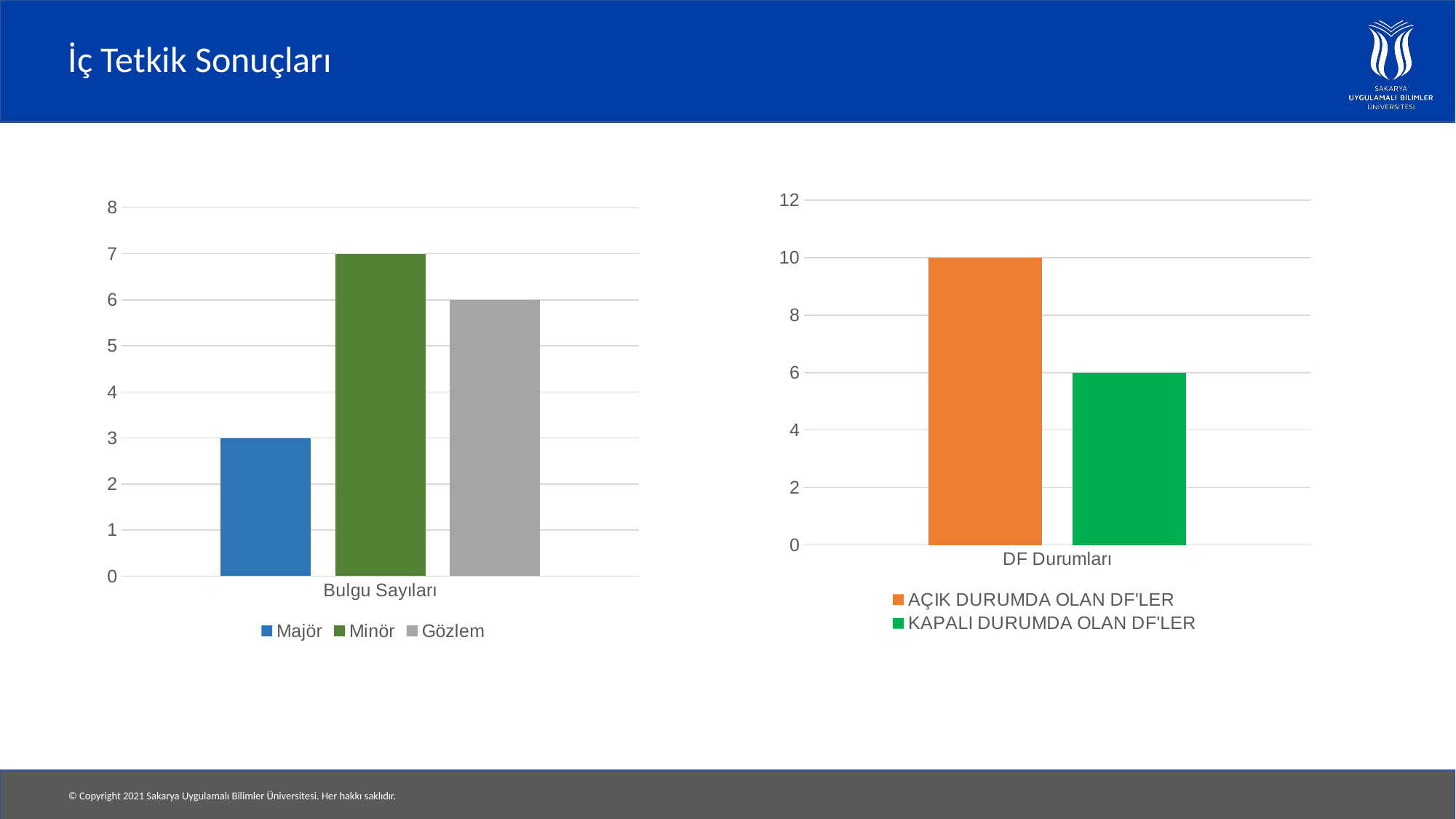
In the right chart (DF Durumları), which is larger: AÇIK DURUMDA OLAN DF'LER or KAPALI DURUMDA OLAN DF'LER? AÇIK DURUMDA OLAN DF'LER In the left chart (Bulgu Sayıları), what is the value for Minör? 7 What kind of chart is the right chart (DF Durumları)? Bar chart In the right chart (DF Durumları), what is the value for AÇIK DURUMDA OLAN DF'LER? 10 In the left chart (Bulgu Sayıları), which series has the lowest value? Majör In the right chart (DF Durumları), what colour is the bar for KAPALI DURUMDA OLAN DF'LER? Green In the left chart (Bulgu Sayıları), which series has the highest value? Minör In the right chart (DF Durumları), what is the value for KAPALI DURUMDA OLAN DF'LER? 6 In the left chart (Bulgu Sayıları), how many series does the legend list? 3 In the right chart (DF Durumları), what is the difference between AÇIK DURUMDA OLAN DF'LER and KAPALI DURUMDA OLAN DF'LER? 4 In the left chart (Bulgu Sayıları), what is the value for Majör? 3 In the left chart (Bulgu Sayıları), what is the difference between the Minör and Majör values? 4